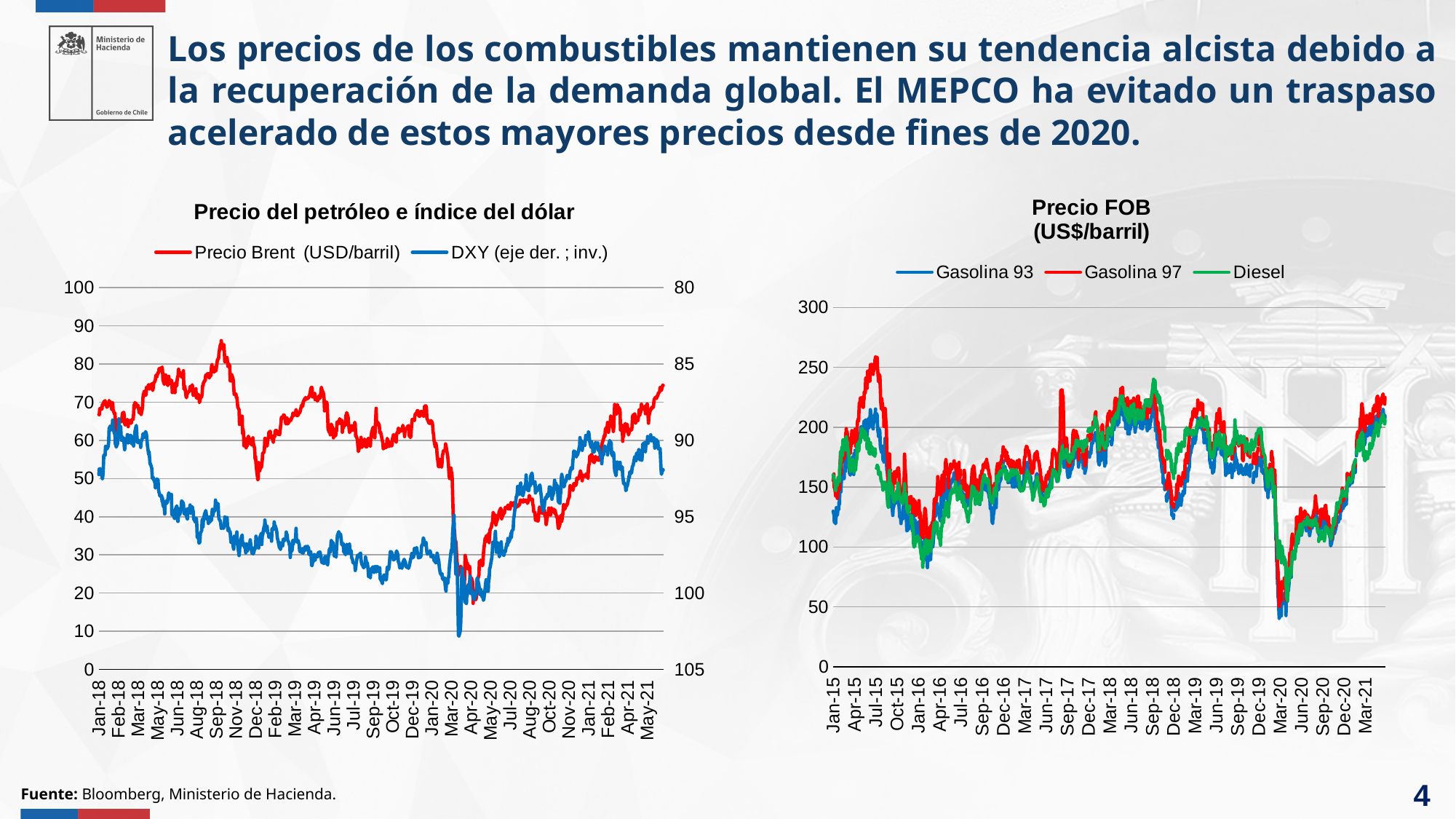
In the right chart 'Precio FOB (US$/barril)', around Jul-15, which is higher: Gasolina 97 or Gasolina 93? Gasolina 97 In the right chart 'Precio FOB (US$/barril)', which series is drawn in green? Diesel In the right chart 'Precio FOB (US$/barril)', do the fuel prices rise or fall between Mar-20 and Mar-21? rise What type of chart is the left chart titled 'Precio del petróleo e índice del dólar'? line chart In the right chart 'Precio FOB (US$/barril)', is the value of Gasolina 93 at its low point around Mar-20 greater or less than 100? less In the left chart, does Precio Brent (USD/barril) rise or fall between Apr-20 and May-21? rise In the right chart 'Precio FOB (US$/barril)', is the value of Gasolina 97 at its peak around Jul-15 greater or less than 200? greater How many series does the legend of the right chart 'Precio FOB (US$/barril)' list? 3 In the left chart 'Precio del petróleo e índice del dólar', which series is plotted on the right-hand (inverted) axis? DXY (eje der. ; inv.) How many series does the legend of the left chart 'Precio del petróleo e índice del dólar' list? 2 In the left chart, is the value of Precio Brent (USD/barril) at its peak around Sep-18 greater or less than 80? greater